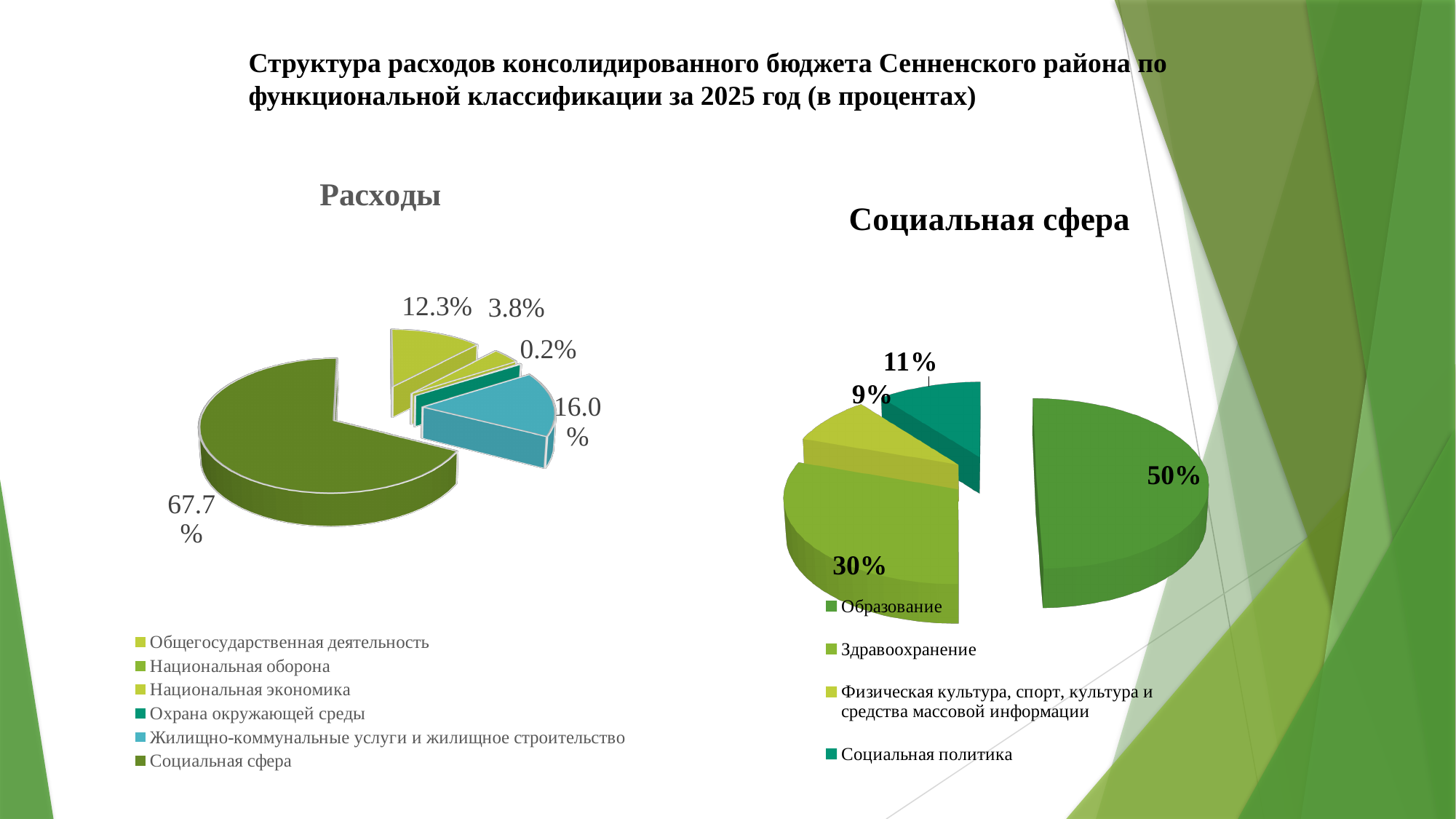
What type of chart is the 'Социальная сфера' chart? Pie chart In the 'Расходы' chart, which category has the largest share? Социальная сфера In the 'Социальная сфера' chart, what is the difference between the shares of Образование and Здравоохранение? 20% In the 'Расходы' chart, which labelled slice has the smallest share? Охрана окружающей среды In the 'Социальная сфера' chart, what share is shown for Социальная политика? 11% In the 'Социальная сфера' chart, what share is shown for Здравоохранение? 30% In the 'Расходы' chart, what share is shown for Социальная сфера? 67.7% In the 'Социальная сфера' chart, which is larger: Социальная политика or Физическая культура, спорт, культура и средства массовой информации? Социальная политика In the 'Расходы' chart, what share is shown for Жилищно-коммунальные услуги и жилищное строительство? 16.0% In the 'Расходы' chart, how many entries does the legend list? 6 In the 'Расходы' chart, what share is shown for Охрана окружающей среды? 0.2% In the 'Социальная сфера' chart, what share is shown for Образование? 50%